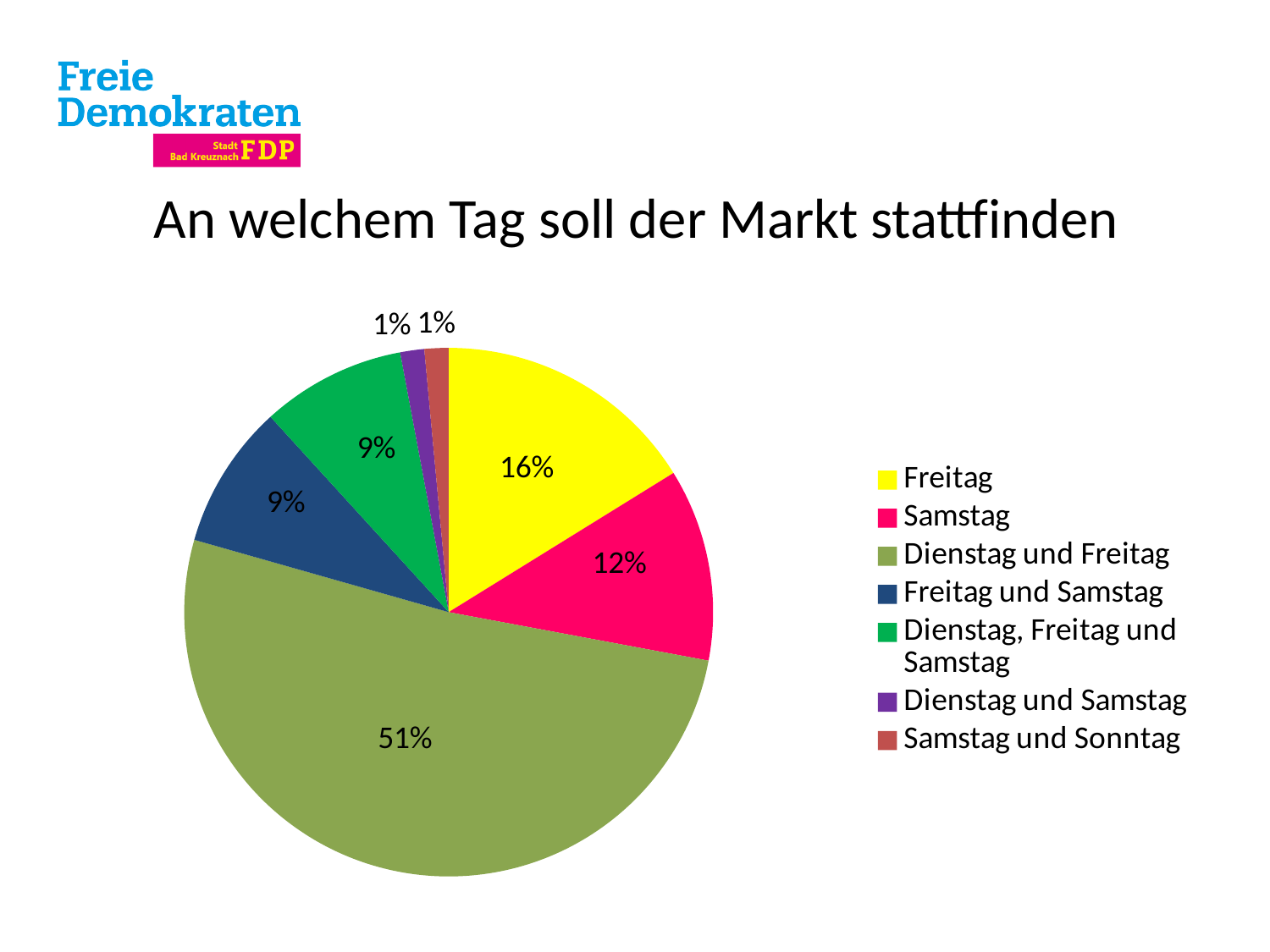
Which colour represents "Samstag und Sonntag" in the legend? brown What is the value for "Dienstag und Samstag"? 1% What share of the pie does "Dienstag und Freitag" have? 51% What is the difference in percentage points between "Dienstag und Freitag" and "Freitag"? 35 percentage points Which category has the largest slice of the pie? Dienstag und Freitag What is the value for "Freitag und Samstag"? 9% What kind of chart is shown on the slide? pie chart What is the title of the chart? An welchem Tag soll der Markt stattfinden What is the value for "Freitag"? 16% How many categories does the pie chart have? 7 Which is larger, the slice for "Freitag" or the slice for "Samstag"? Freitag What is the value for "Samstag"? 12%